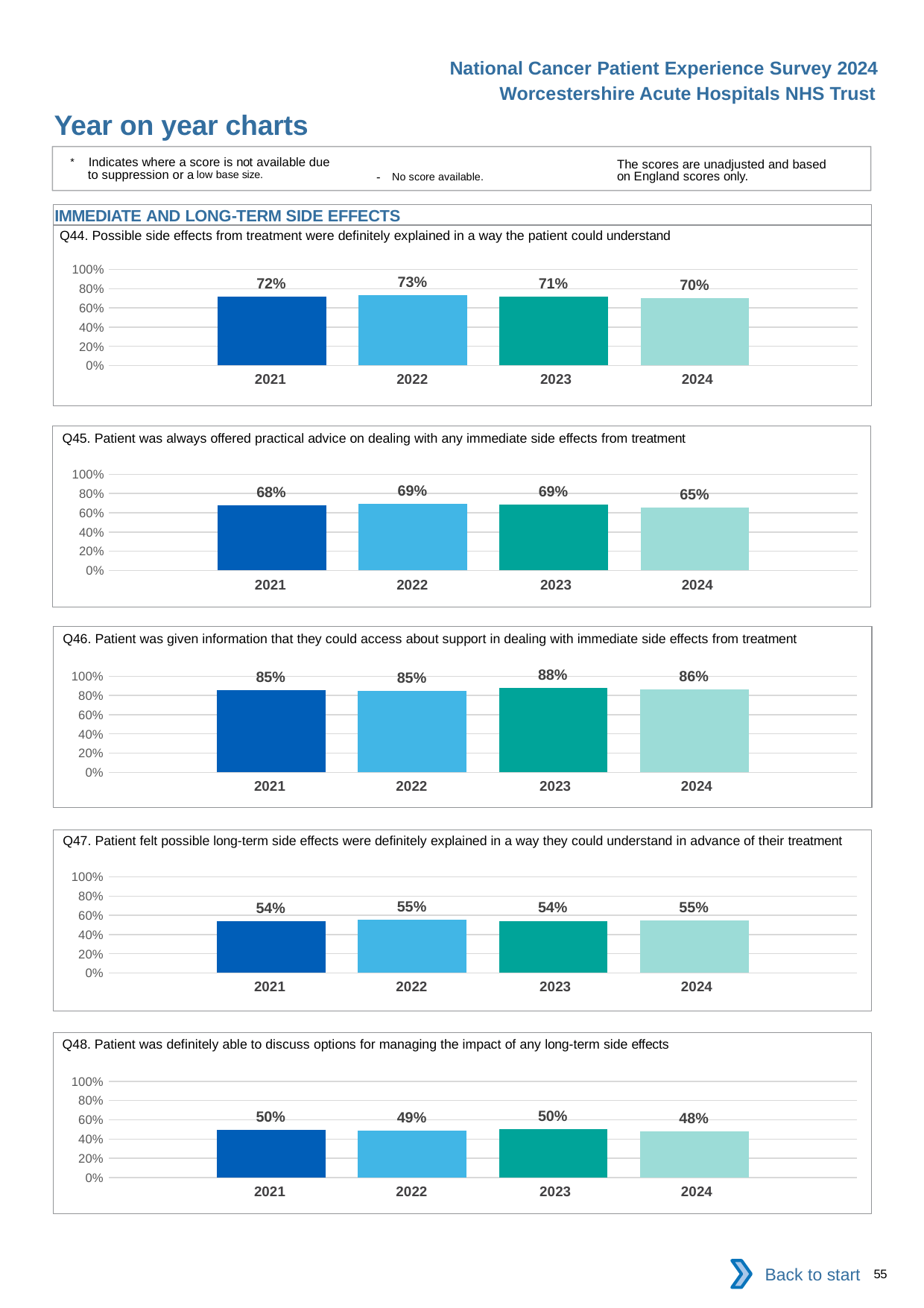
In the Q48 chart, what is the value for 2022? 49% In the Q47 chart, is the value for 2023 greater or less than 60%? less In the Q46 chart, which year has the highest value? 2023 In the Q45 chart, what is the difference between the 2023 value and the 2024 value? 4 percentage points How many years are shown on the x axis of the Q44 chart? 4 What kind of chart is the Q45 chart? bar chart In the Q44 chart, which year has the lowest value? 2024 In the Q47 chart, what is the value for 2022? 55% In the Q48 chart, which is larger, the value for 2021 or the value for 2024? 2021 In the Q45 chart, what is the value for 2024? 65% In the Q44 chart, what is the value for 2022? 73% In the Q46 chart, what is the value for 2021? 85%